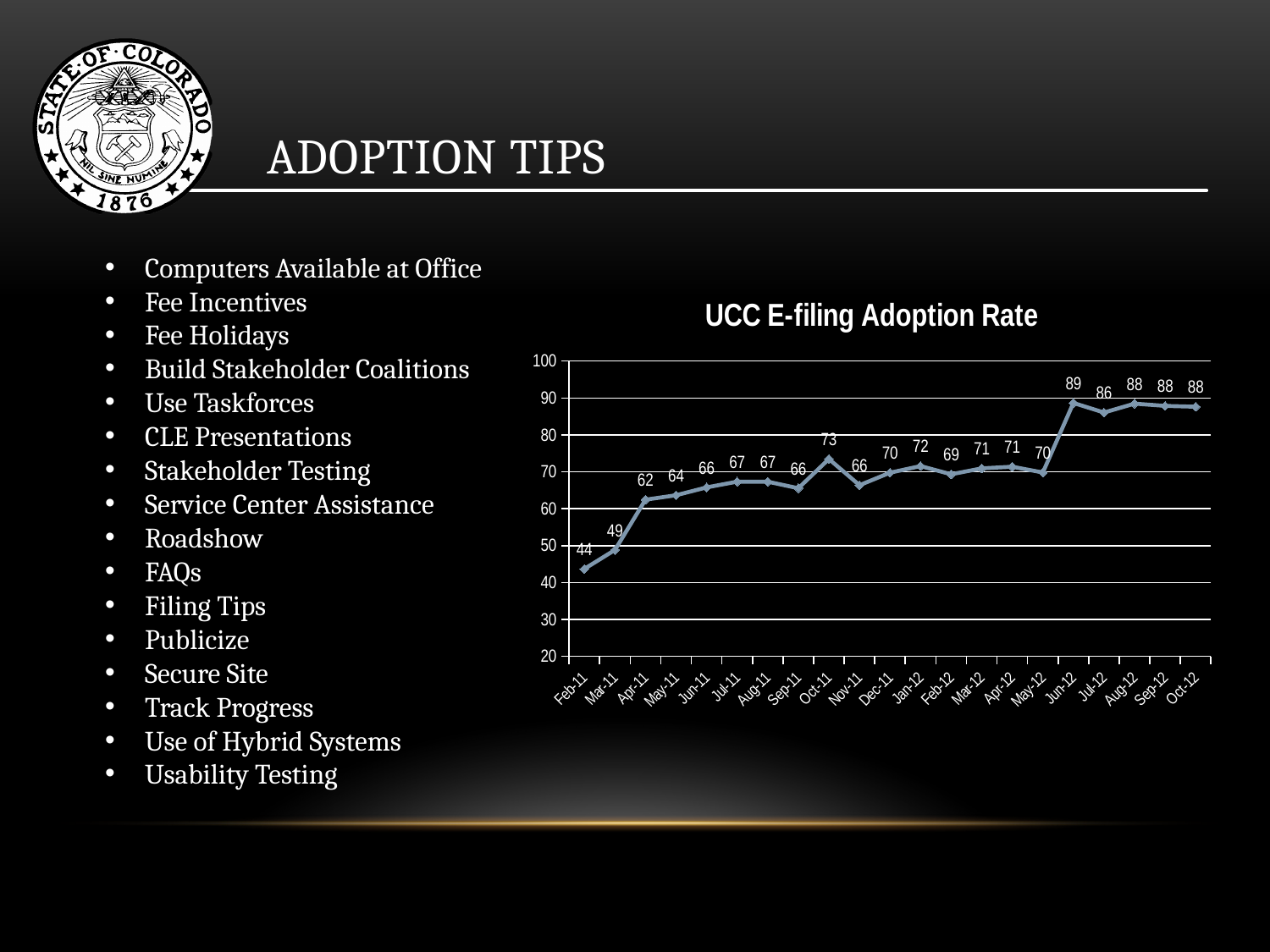
Which month has a higher adoption rate, Oct-11 or Nov-11? Oct-11 What is the difference between the adoption rate in Oct-12 and in Feb-11? 44 What is the difference between the adoption rate in Jun-12 and in May-12? 19 What is the title of the chart? UCC E-filing Adoption Rate Does the UCC e-filing adoption rate generally rise or fall from Feb-11 to Oct-12? rise What is the UCC e-filing adoption rate for Oct-11? 73 What type of chart is shown on the slide? line chart Which month has the lowest UCC e-filing adoption rate? Feb-11 What is the UCC e-filing adoption rate for Feb-11? 44 What is the UCC e-filing adoption rate for Jul-12? 86 How many months are plotted on the chart? 21 Which month has the highest UCC e-filing adoption rate? Jun-12